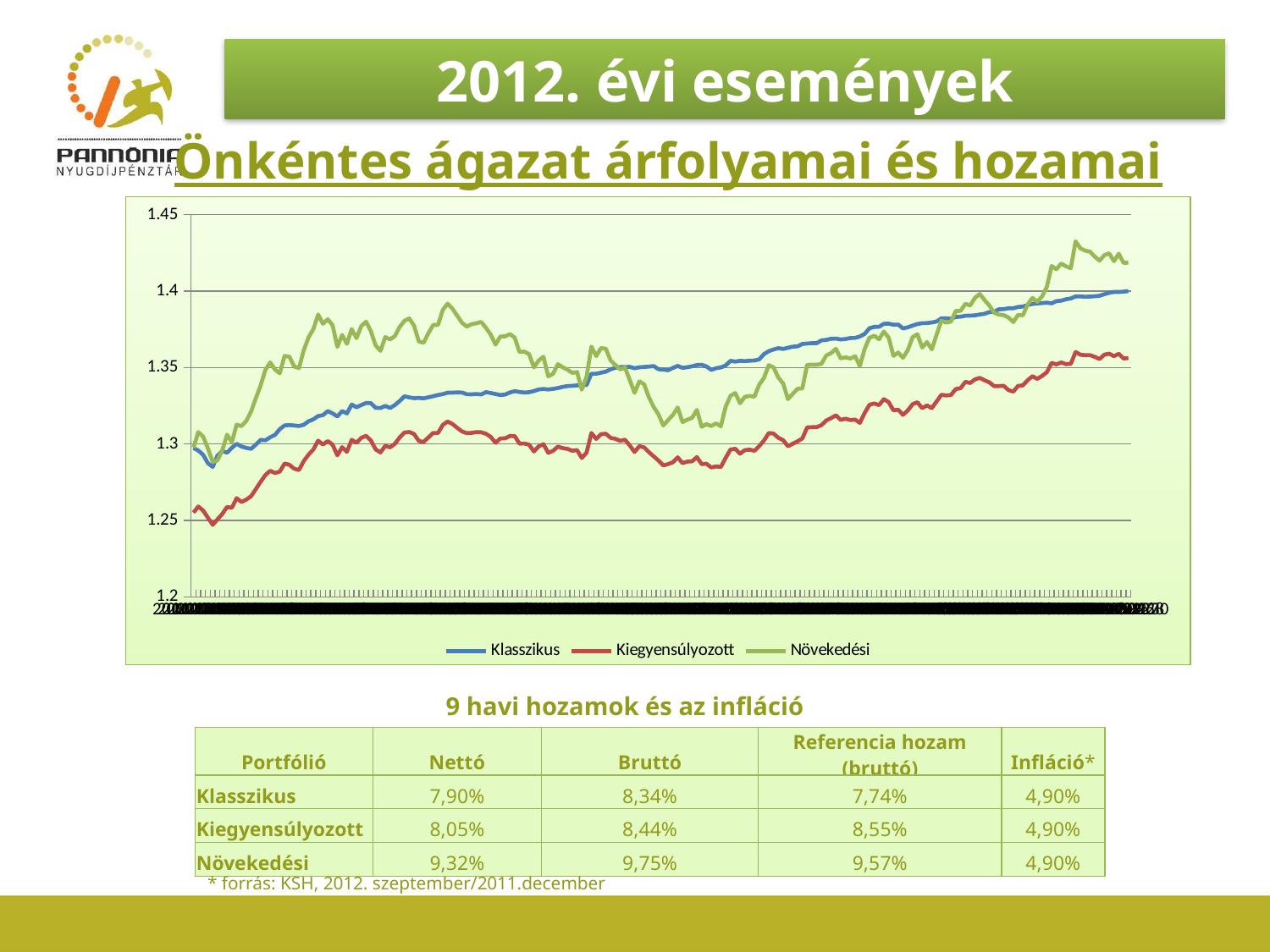
At the left end of the chart, is the Kiegyensúlyozott value greater or less than 1.3? less At the right end of the chart, which is larger: the Növekedési value or the Kiegyensúlyozott value? Növekedési At the right end of the chart, is the Növekedési value greater or less than 1.4? greater What kind of chart is shown on the slide? line chart At the right end of the chart, is the Klasszikus value greater or less than 1.35? greater How many series does the chart's legend list? 3 What colour is the Klasszikus line in the chart? blue Which series are listed in the chart's legend? Klasszikus, Kiegyensúlyozott, Növekedési Which series has the highest value at the right end of the chart? Növekedési Does the Klasszikus line generally rise or fall from left to right across the chart? rise Which series has the lowest value at the right end of the chart? Kiegyensúlyozott